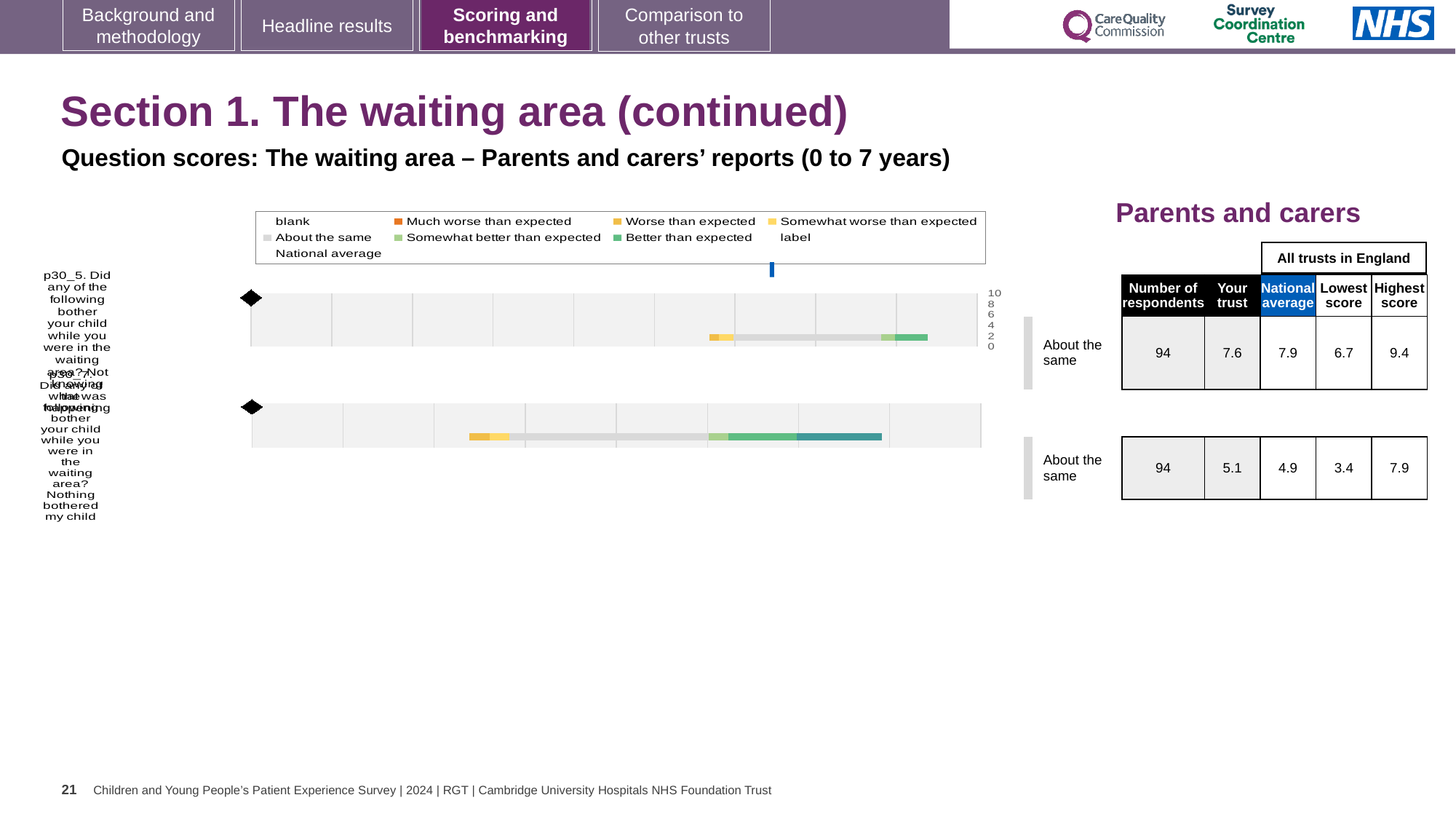
For the top question (p30_5), which is larger: the 'Your trust' score or the national average? National average What kind of chart is used to show the question scores on this slide? bar chart In the table, what is the number of respondents for the top question (p30_5)? 94 In the table, what is the national average for the top question (p30_5)? 7.9 How many question bar charts are shown on the slide? 2 How many entries does the chart legend list? 9 In the table, what is the highest score for the bottom question (p30_7)? 7.9 For the bottom question (p30_7), which is larger: the 'Your trust' score or the national average? Your trust In the table, what is the 'Your trust' score for the top question (p30_5)? 7.6 For the top question (p30_5), what is the difference between the highest score and the lowest score in the table? 2.7 Which benchmark category is shown next to both question charts? About the same What heading appears above the table on the right of the slide? Parents and carers